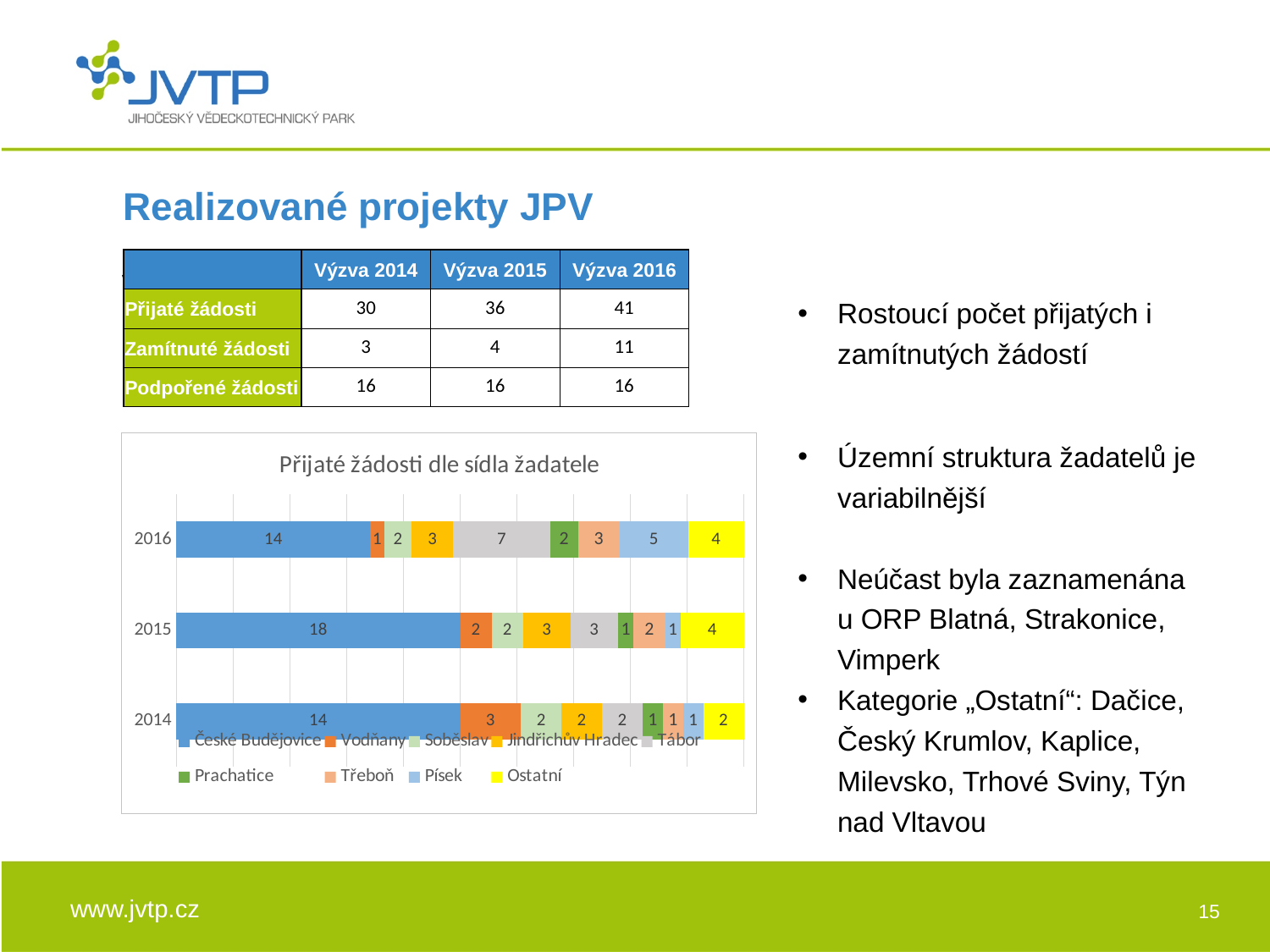
In the chart 'Přijaté žádosti dle sídla žadatele', is the Písek value larger in 2016 or in 2015? 2016 What is the title of the chart on the slide? Přijaté žádosti dle sídla žadatele In the chart 'Přijaté žádosti dle sídla žadatele', what is the total of the stacked bar for 2016? 41 In the chart 'Přijaté žádosti dle sídla žadatele', what is the difference between the Tábor value in 2016 and in 2015? 4 How many years are shown on the y axis of the chart 'Přijaté žádosti dle sídla žadatele'? 3 In the chart 'Přijaté žádosti dle sídla žadatele', what is the value for Písek in 2016? 5 How many series does the legend of the chart 'Přijaté žádosti dle sídla žadatele' list? 9 In the chart 'Přijaté žádosti dle sídla žadatele', what is the value for České Budějovice in 2015? 18 In the chart 'Přijaté žádosti dle sídla žadatele', what is the value for Tábor in 2016? 7 In the chart 'Přijaté žádosti dle sídla žadatele', which year has the highest value for České Budějovice? 2015 In the chart 'Přijaté žádosti dle sídla žadatele', what is the value for Ostatní in 2015? 4 What kind of chart is 'Přijaté žádosti dle sídla žadatele'? Stacked bar chart